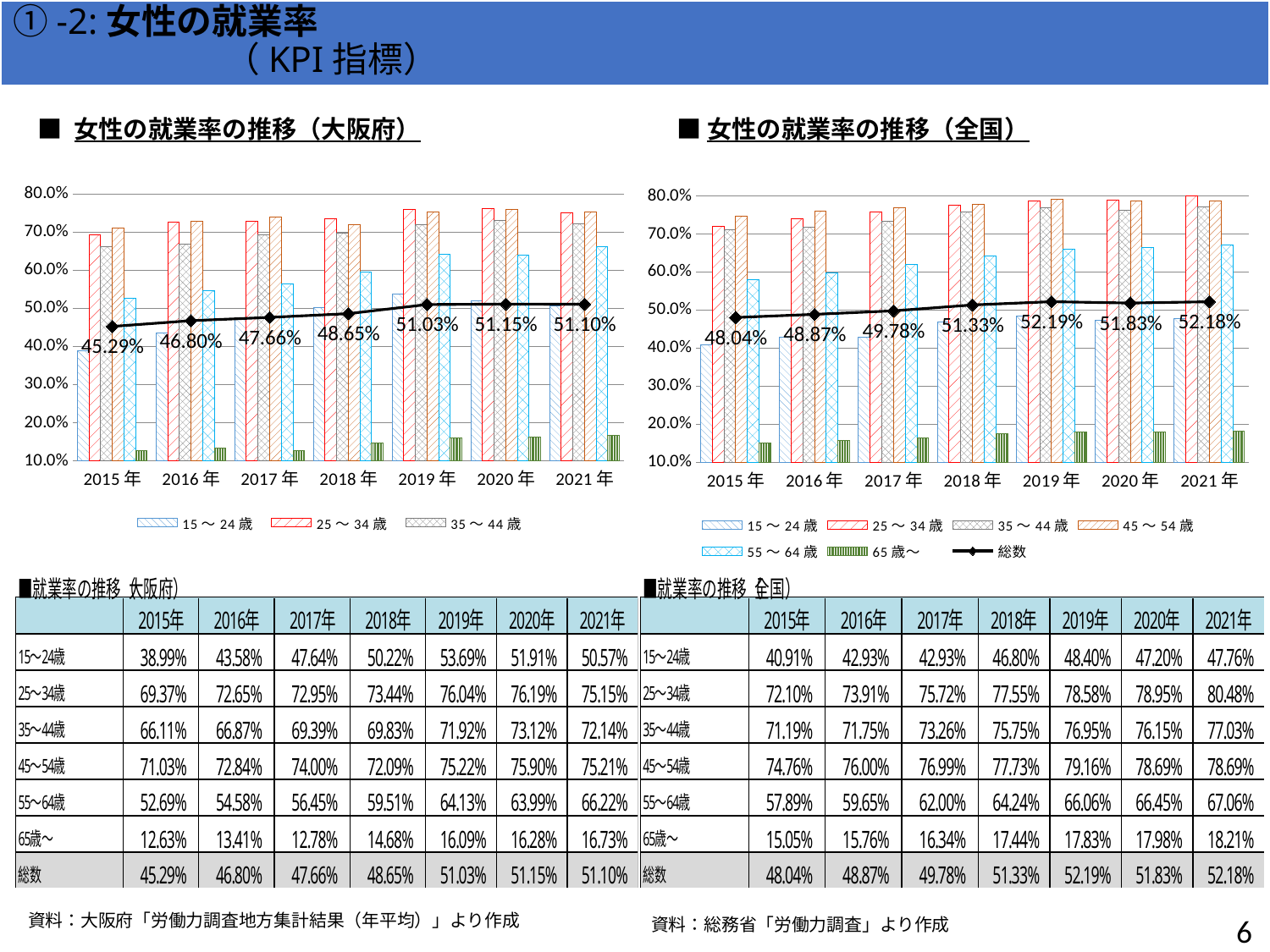
What kind of chart is the 女性の就業率の推移（大阪府） chart on the left? bar and line chart In the 女性の就業率の推移（大阪府） chart, by how many percentage points did the 総数 value rise from 2015年 to 2021年? 5.81 percentage points In the 女性の就業率の推移（全国） chart, what is the 総数 value for 2021年? 52.18% In the 女性の就業率の推移（大阪府） chart, is the 65歳～ bar for 2015年 greater or less than 20.0%? less In the 女性の就業率の推移（全国） chart, does the 総数 line rise or fall from 2015年 to 2019年? rise In the 女性の就業率の推移（大阪府） chart, what is the 総数 value for 2015年? 45.29% For 2019年, which is larger: the 総数 value in the 大阪府 chart or in the 全国 chart? 全国 How many years are shown on the x axis of the 女性の就業率の推移（全国） chart? 7 In the 女性の就業率の推移（全国） chart, what is the difference between the 総数 values for 2018年 and 2017年? 1.55 percentage points In the 女性の就業率の推移（大阪府） chart, which year has the highest 総数 value? 2020年 In the 女性の就業率の推移（全国） chart, which year has the lowest 総数 value? 2015年 How many series does the legend of the 女性の就業率の推移（全国） chart list? 7